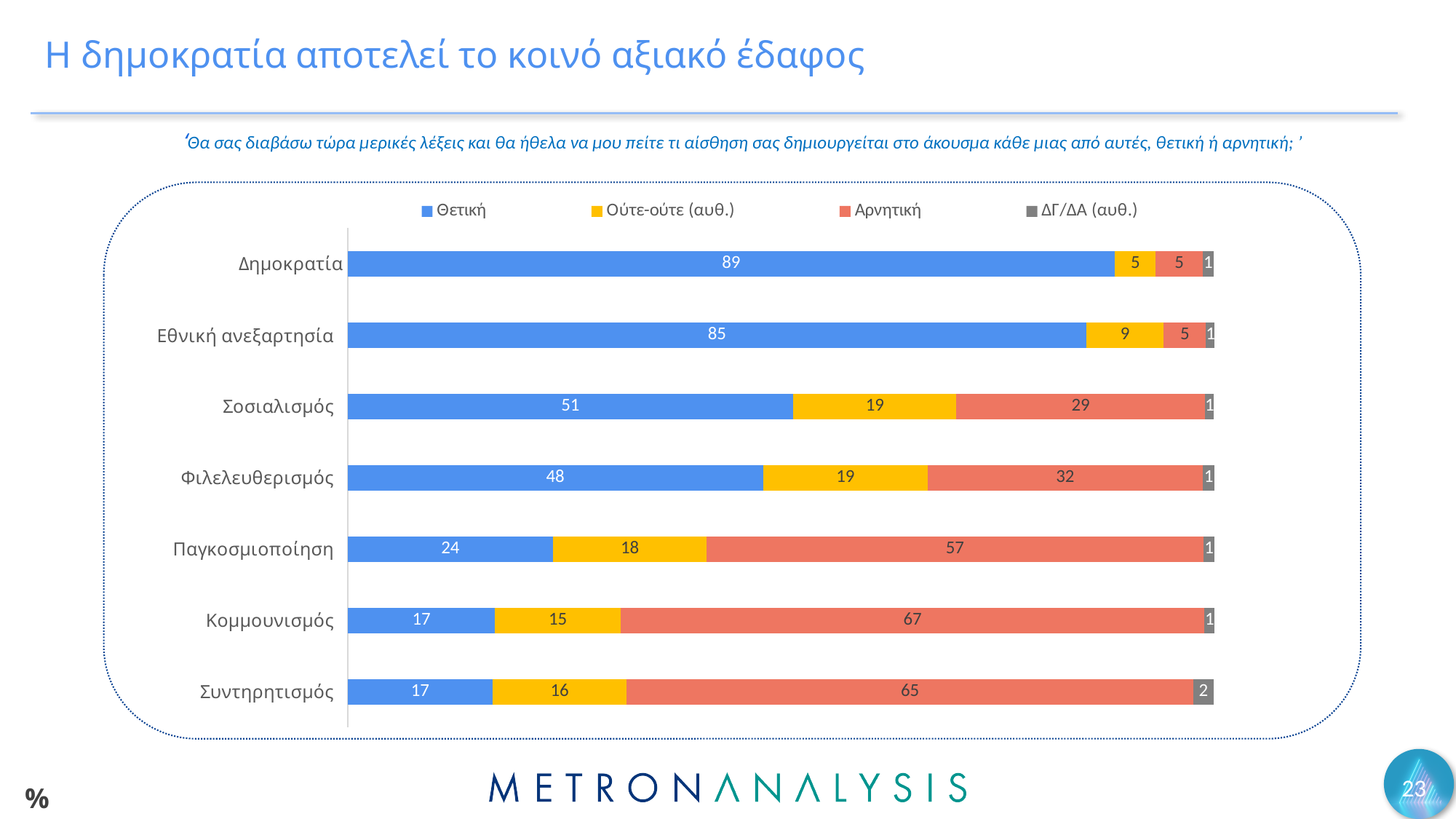
How many categories are shown in the chart? 7 What is the Ούτε-ούτε (αυθ.) value for Εθνική ανεξαρτησία? 9 Which category has the highest Θετική value? Δημοκρατία What is the difference between the Θετική values for Σοσιαλισμός and Φιλελευθερισμός? 3 Which category has the highest Αρνητική value? Κομμουνισμός What is the Θετική value for Δημοκρατία? 89 How many series does the legend list? 4 What kind of chart is shown on the slide? Stacked bar chart What is the total of the stacked bar for Συντηρητισμός? 100 Which category has the lowest Αρνητική value? Δημοκρατία and Εθνική ανεξαρτησία (both 5) Which is larger: the Αρνητική value for Κομμουνισμός or for Συντηρητισμός? Κομμουνισμός What is the Αρνητική value for Παγκοσμιοποίηση? 57